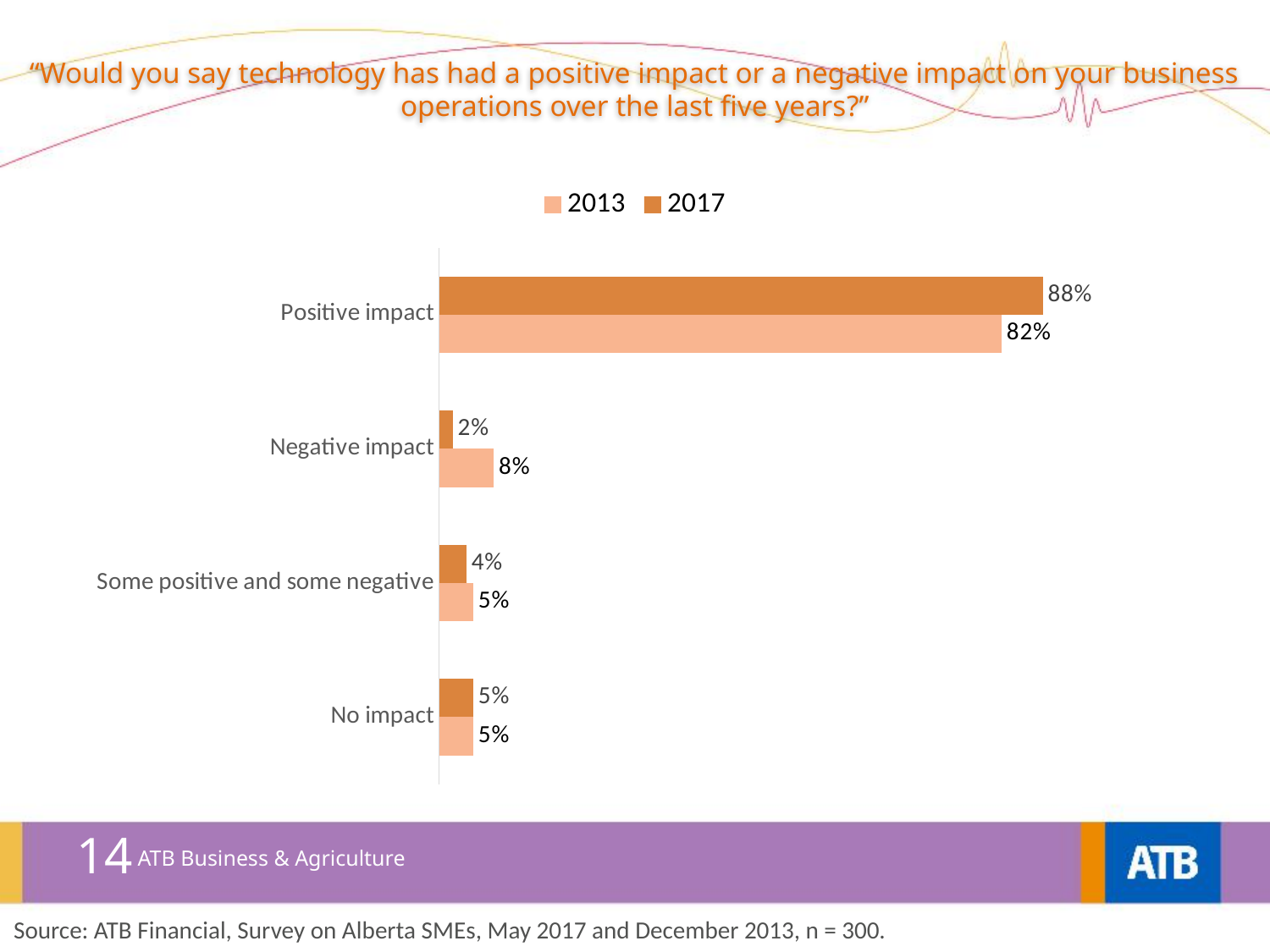
Which category has the highest 2017 value? Positive impact What is the 2013 value for No impact? 5% How many categories are shown on the chart? 4 What kind of chart is shown on the slide? Bar chart What is the 2017 value for Some positive and some negative? 4% How many series does the legend list? 2 What is the difference between the 2017 and 2013 values for Positive impact? 6% What is the 2017 value for Positive impact? 88% Which category has the lowest 2017 value? Negative impact What is the 2013 value for Negative impact? 8% Which two years are listed in the legend? 2013 and 2017 Which is larger for Negative impact, the 2013 value or the 2017 value? 2013